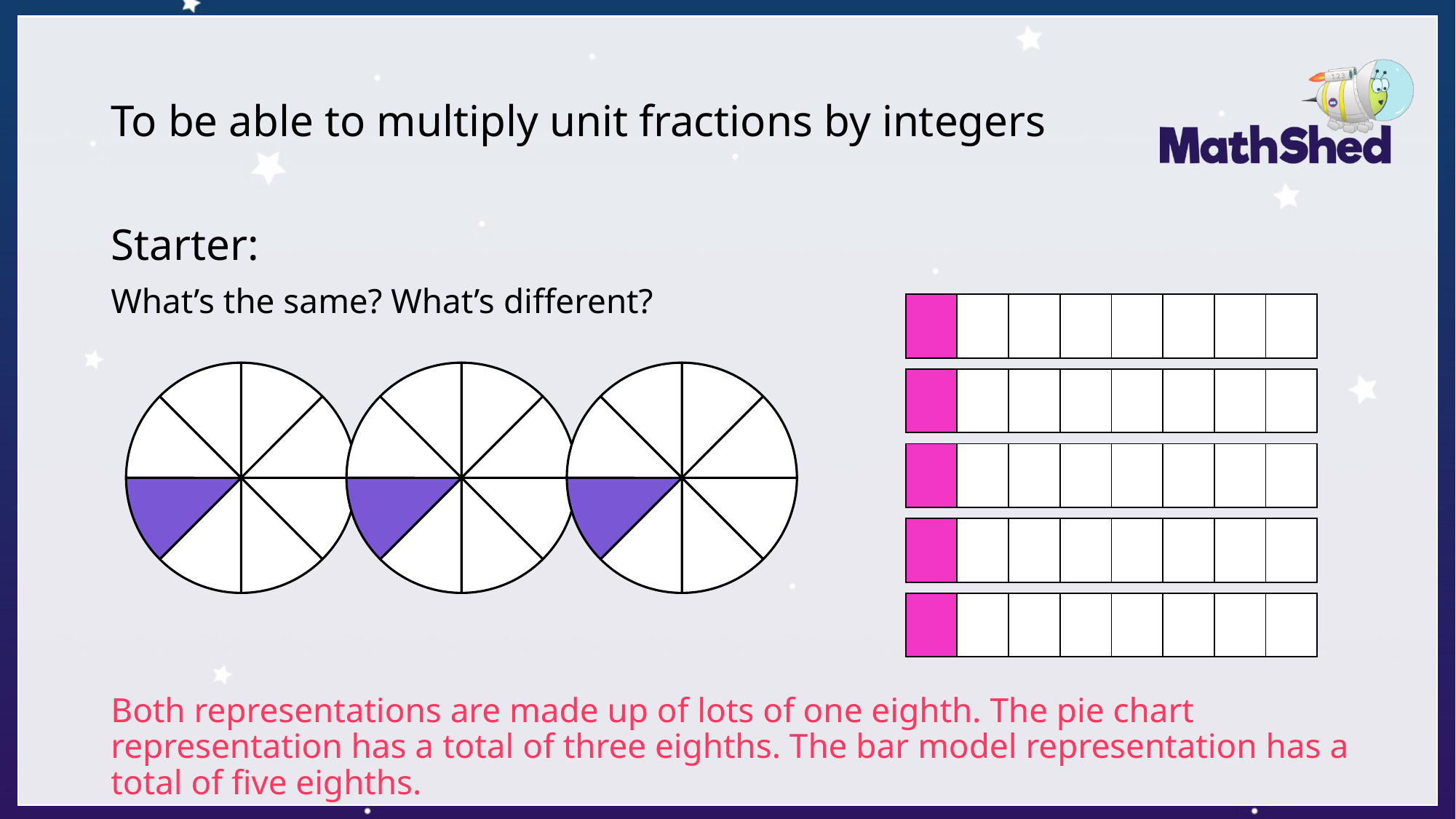
According to the slide, what is the total shown by the bar model representation? five eighths What fraction of each circle on the left is shaded? one eighth Into how many equal sections is each bar on the right divided? 8 What colour are the shaded parts of the circles on the left? purple How many parts of each circle on the left are shaded purple? 1 According to the slide, what is the total shown by the pie chart representation? three eighths Into how many equal parts is each circle on the left divided? 8 Which representation shows the larger total, the pie charts or the bar models? the bar models What colour are the shaded sections of the bars on the right? pink